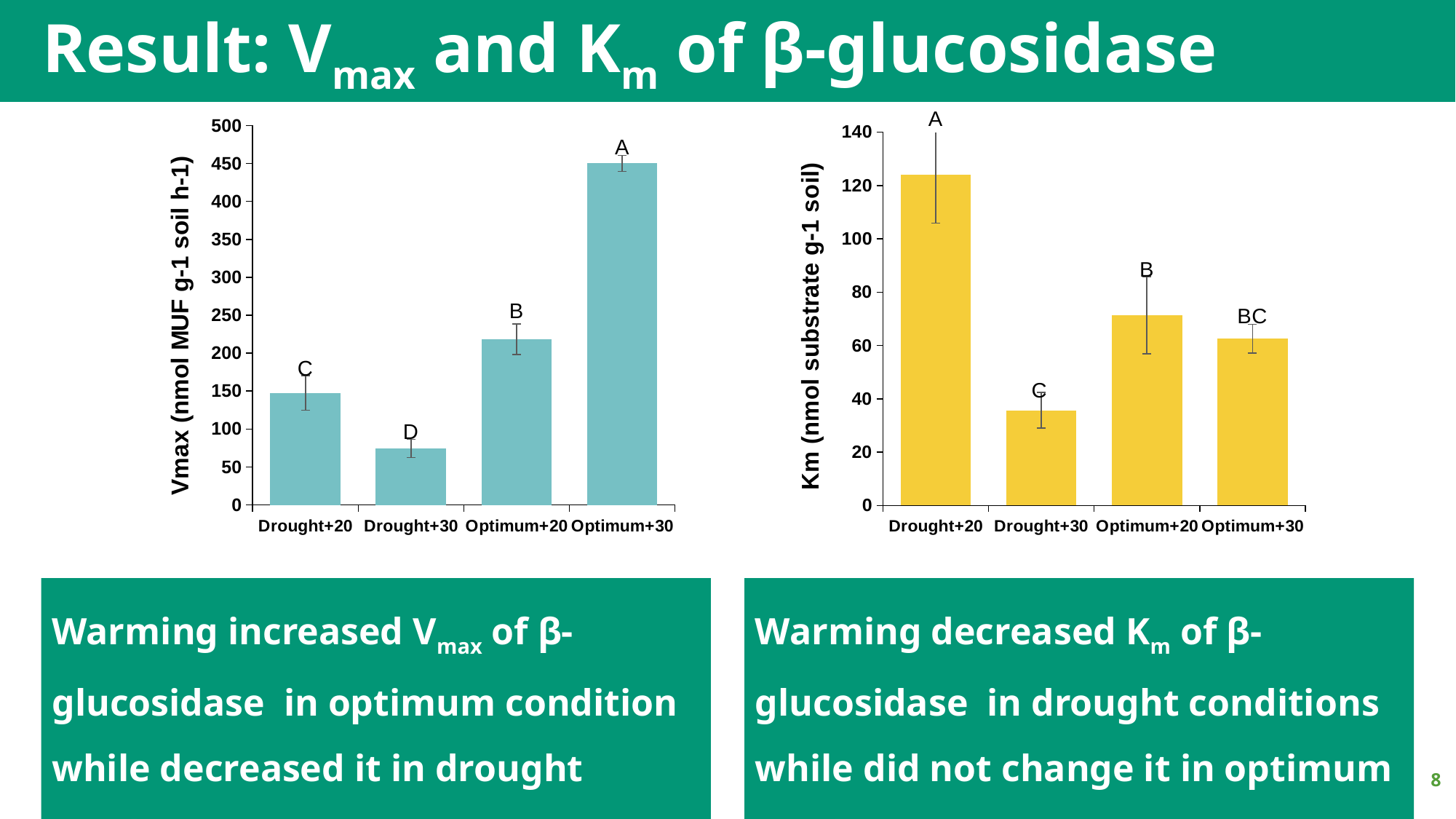
In the right chart (Km), is the value for Drought+20 greater or less than 100? greater In the left chart (Vmax), is the value for Drought+30 greater or less than 100? less In the right chart (Km), which category has the lowest value? Drought+30 In the right chart (Km), is the value for Drought+30 greater or less than 40? less In the left chart (Vmax), which category has the lowest value? Drought+30 How many categories are shown on the x axis of the left chart (Vmax)? 4 In the left chart (Vmax), which category has the highest value? Optimum+30 What kind of chart is the right chart (Km)? bar chart In the right chart (Km), which category has the highest value? Drought+20 In the left chart (Vmax), which is larger, Optimum+20 or Drought+20? Optimum+20 In the right chart (Km), which is larger, Drought+20 or Optimum+20? Drought+20